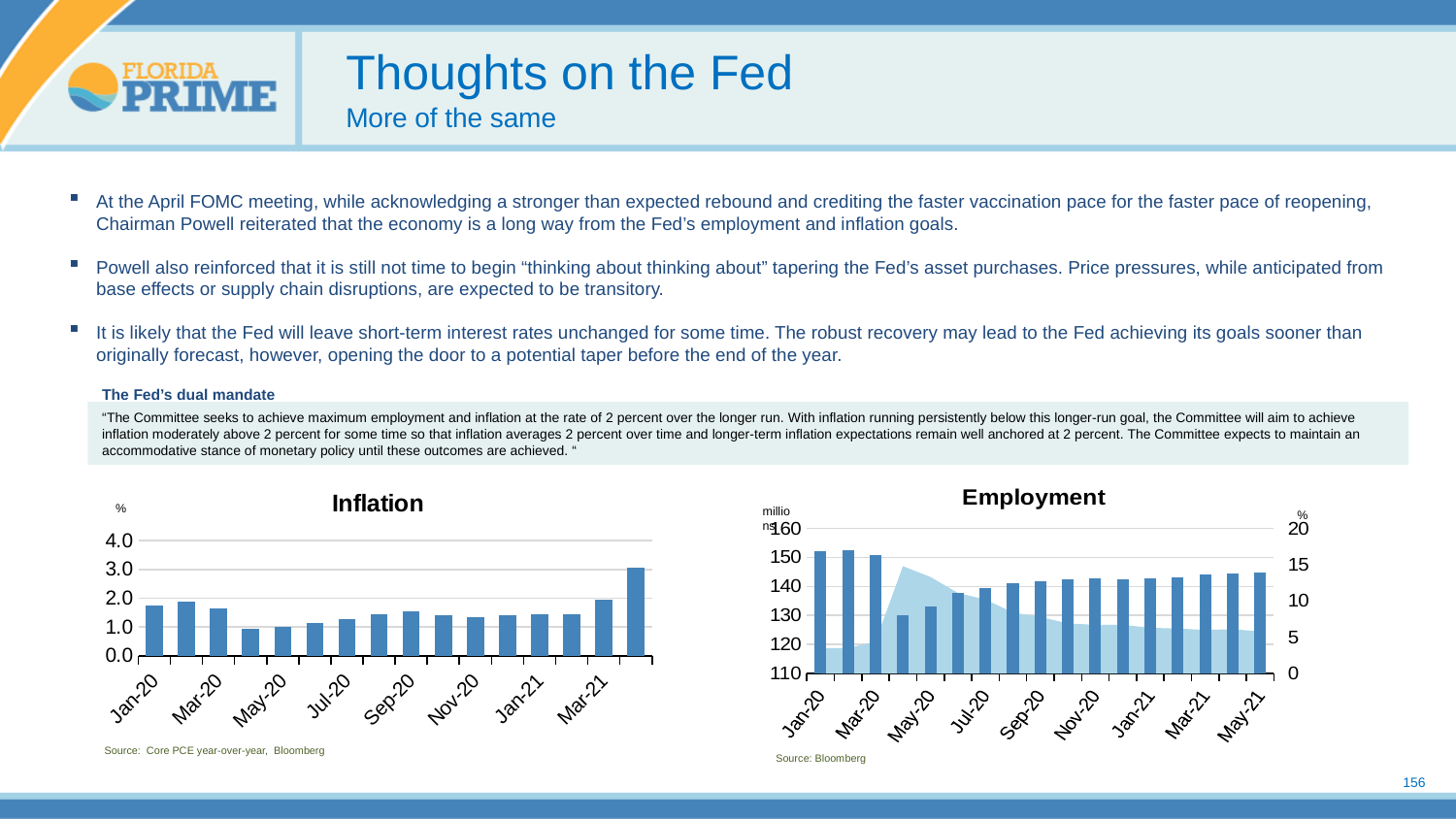
On the Inflation chart, is the value for Jul-20 greater or less than 2.0? less On the Inflation chart, which is larger, the value for Jan-20 or the value for Jul-20? Jan-20 What is the highest tick on the right-hand axis of the Employment chart? 20 What is the highest tick shown on the y axis of the Inflation chart? 4.0 On the Inflation chart, is the value for Jan-20 greater or less than 2.0? less On the Employment chart, is the bar for Jan-20 greater or less than 150? greater What kind of chart is the Inflation chart? Bar chart On the Employment chart, which bar is taller, Jan-20 or May-20? Jan-20 On the Employment chart, do the bars rise or fall from May-20 to May-21? rise What source is cited below the Inflation chart? Core PCE year-over-year, Bloomberg On the Inflation chart, do the values rise or fall from Jan-21 to the last bar? rise